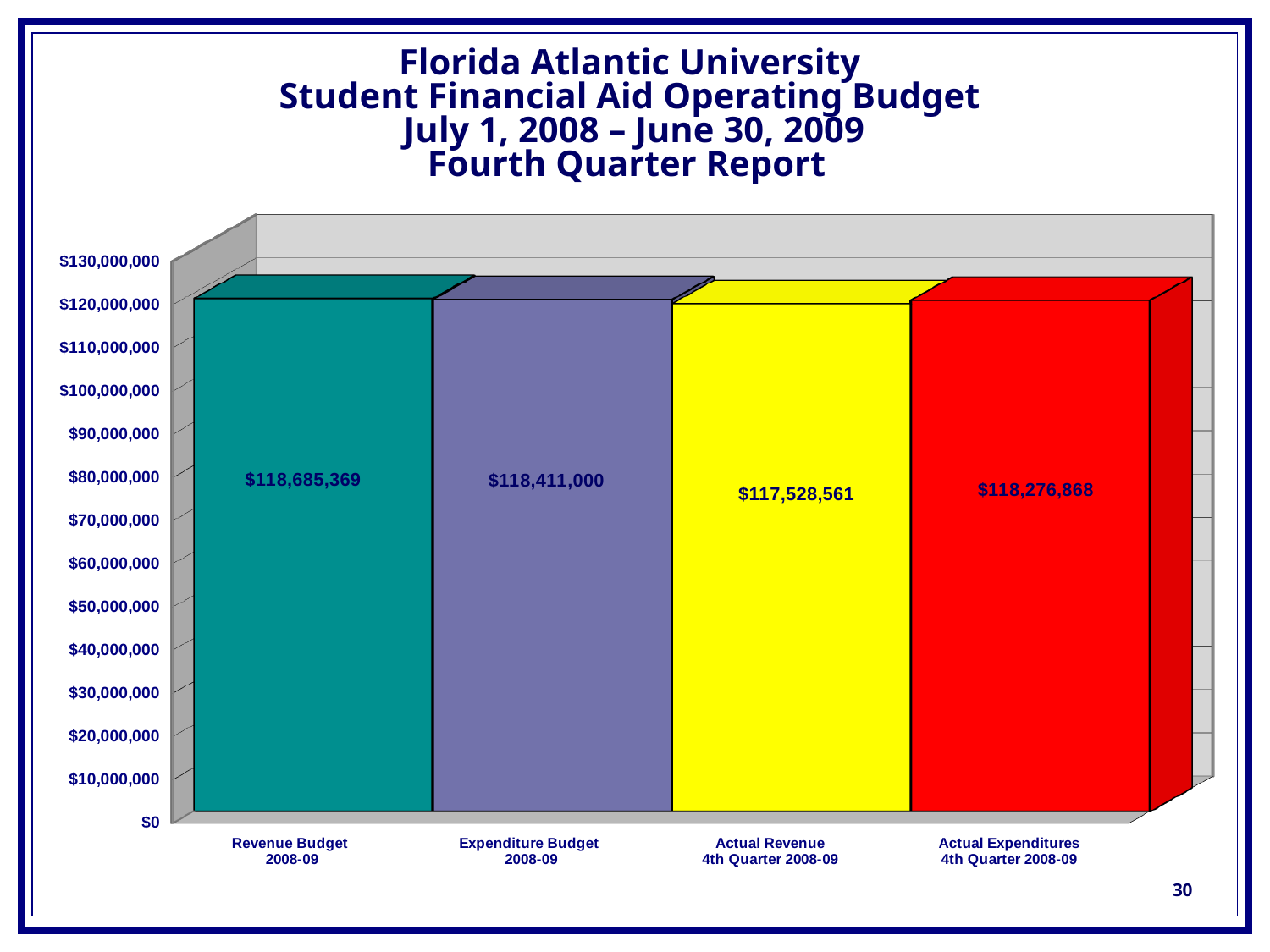
How many bars are shown in the chart? 4 Is the value for Actual Revenue 4th Quarter 2008-09 greater or less than $120,000,000? less Which is larger, Actual Revenue 4th Quarter 2008-09 or Actual Expenditures 4th Quarter 2008-09? Actual Expenditures 4th Quarter 2008-09 What is the value shown for Actual Revenue 4th Quarter 2008-09? $117,528,561 What is the value shown for Actual Expenditures 4th Quarter 2008-09? $118,276,868 Which category has the highest value? Revenue Budget 2008-09 What is the value of the Revenue Budget 2008-09 bar? $118,685,369 How much larger is the Expenditure Budget 2008-09 than the Actual Expenditures 4th Quarter 2008-09? $134,132 Which category has the lowest value? Actual Revenue 4th Quarter 2008-09 What type of chart is shown on the slide? Bar chart What is the difference between the Revenue Budget 2008-09 and the Expenditure Budget 2008-09? $274,369 What is the value of the Expenditure Budget 2008-09 bar? $118,411,000